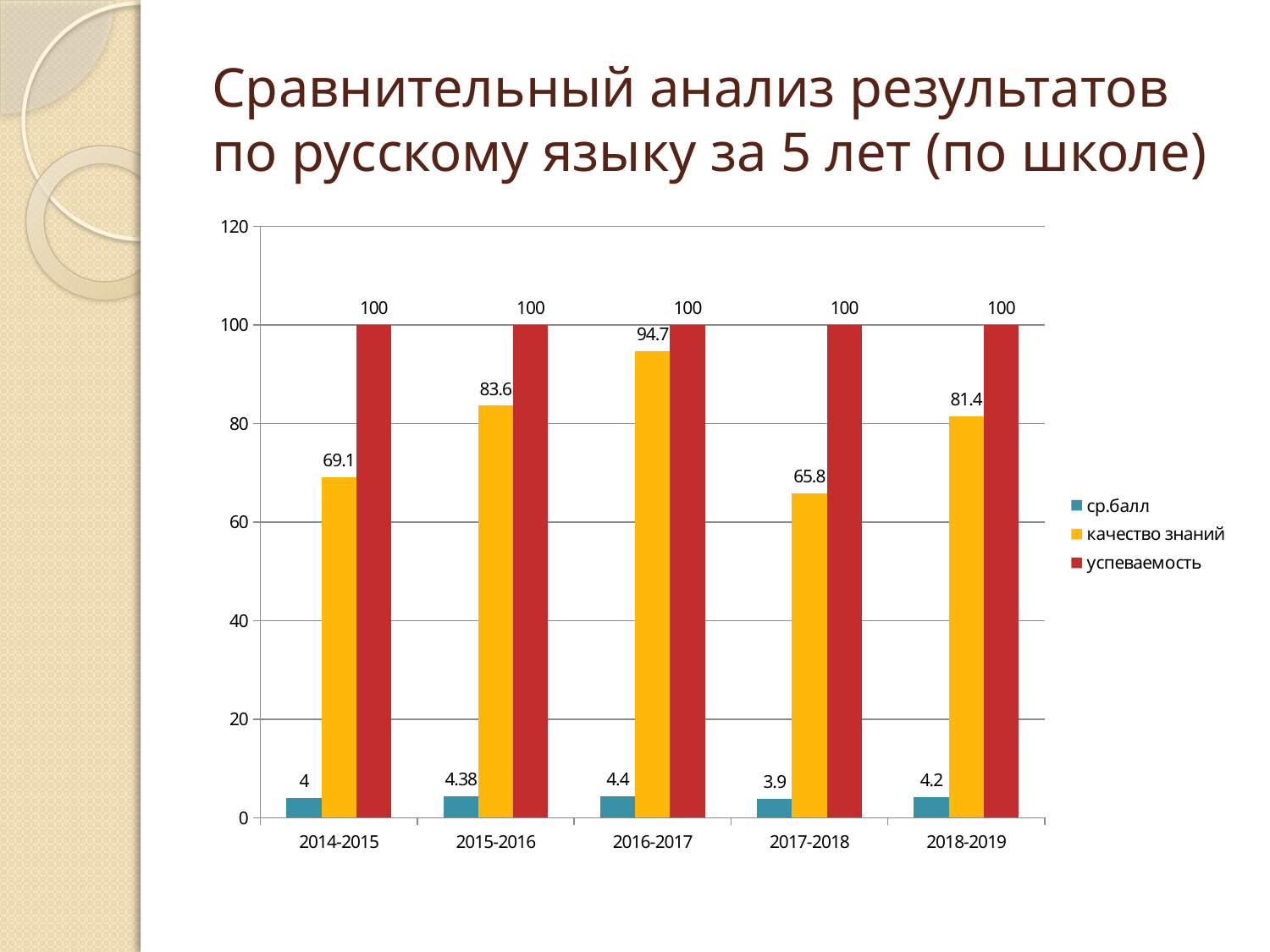
How many years are shown on the x axis? 5 What kind of chart is shown on the slide? bar chart Which year has the lowest value for ср.балл? 2017-2018 What is the value of ср.балл for 2015-2016? 4.38 What is the difference between качество знаний in 2015-2016 and 2014-2015? 14.5 How many series does the legend list? 3 What is the value of успеваемость for 2018-2019? 100 Which series is shown in red in the legend? успеваемость What is the value of качество знаний for 2016-2017? 94.7 Which is larger: качество знаний in 2018-2019 or in 2017-2018? 2018-2019 Is the value of качество знаний for 2017-2018 greater or less than 80? less Which year has the highest value for качество знаний? 2016-2017